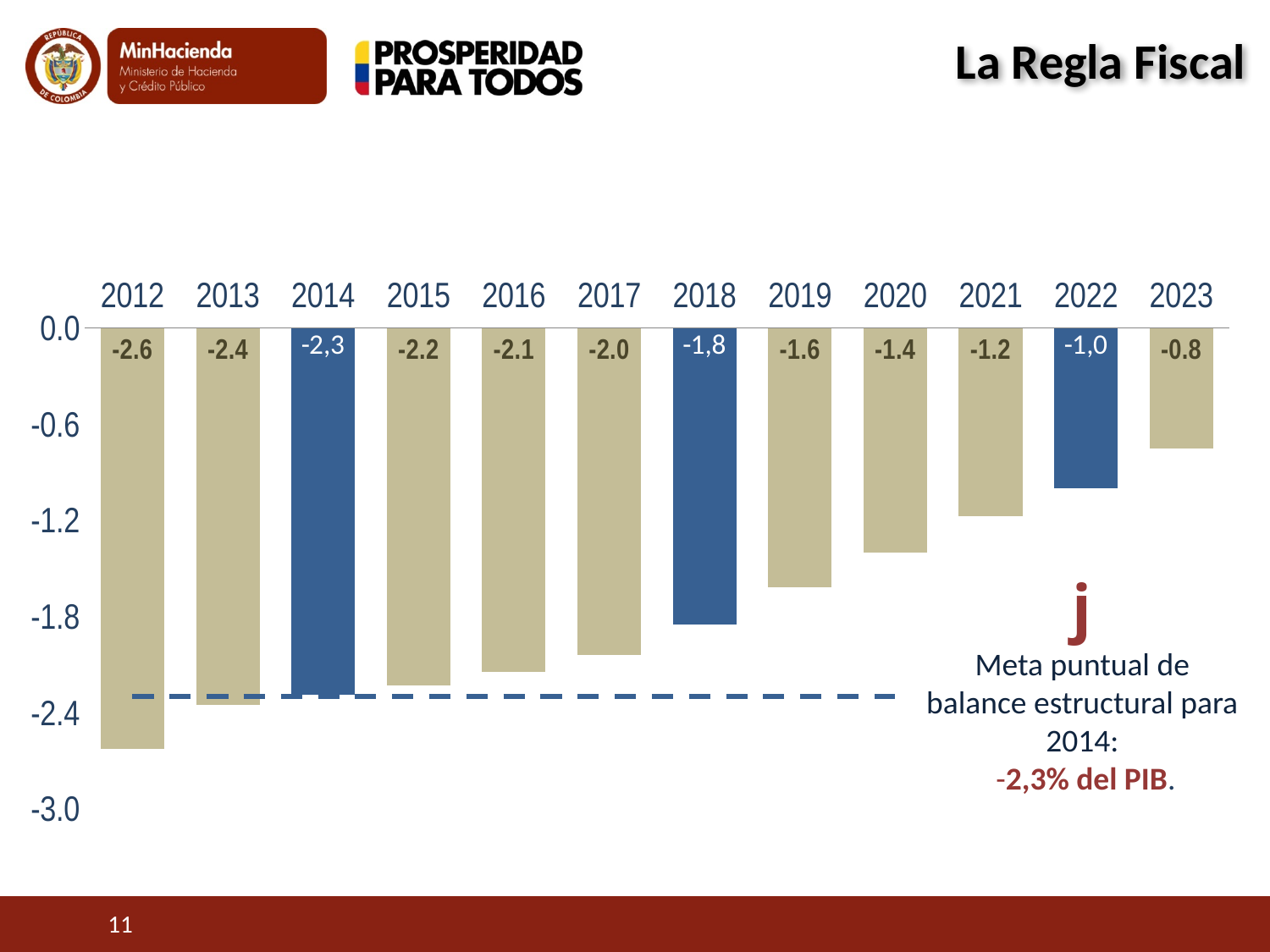
How many years are shown on the x axis? 12 Is the value for 2020 greater or less than -1.2? less What is the value shown for 2018? -1,8 Which year has the highest (least negative) value? 2023 What is the value shown for 2023? -0.8 What is the difference between the values for 2012 and 2023? 1.8 What is the value shown for 2014? -2,3 What is the value shown for 2012? -2.6 Do the values rise or fall from 2012 to 2023? rise Which is larger, the value for 2016 or the value for 2020? 2020 What kind of chart is shown on the slide? bar chart Which year has the lowest (most negative) value? 2012